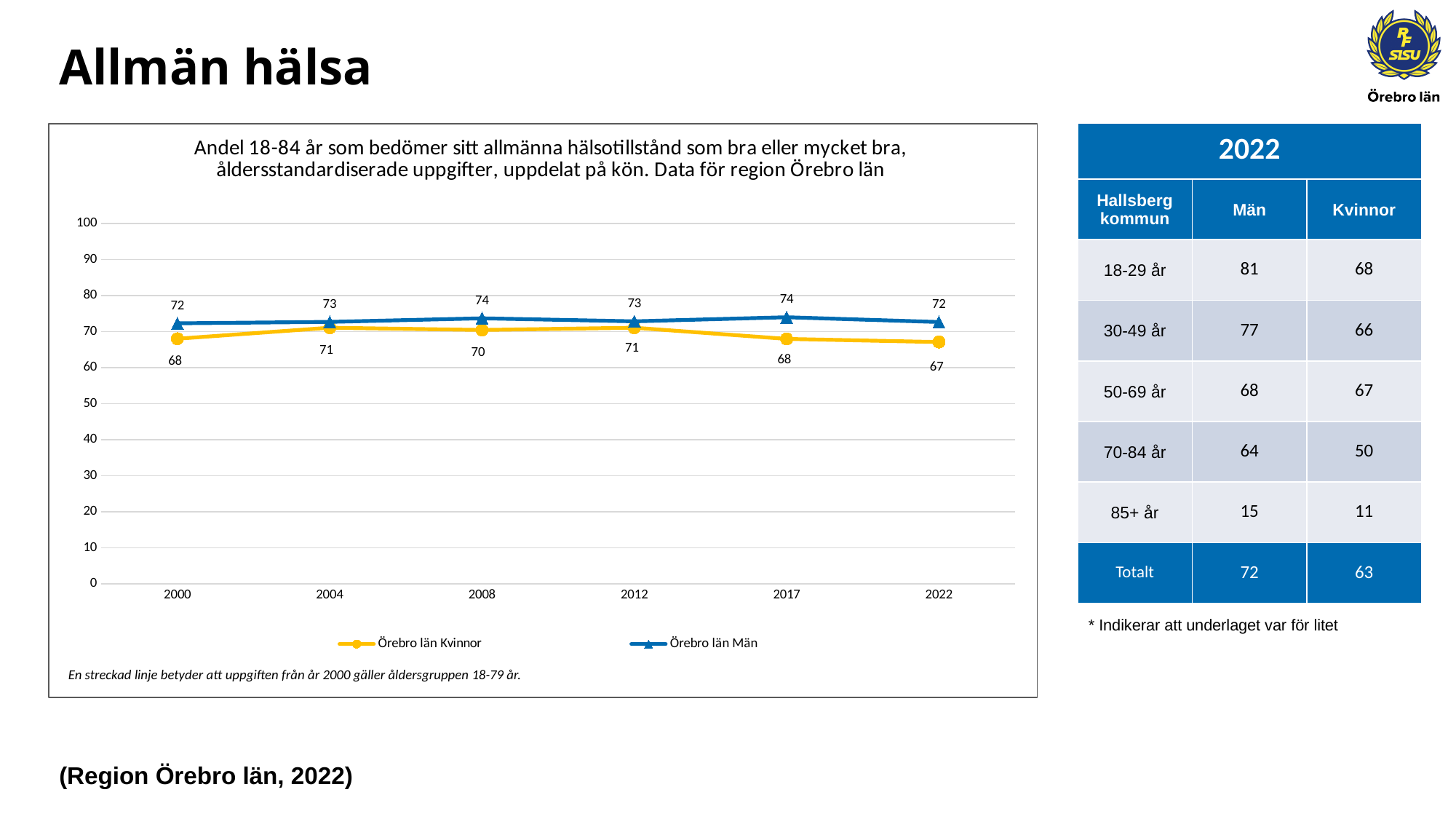
How many years are shown on the x axis? 6 What is the value for Örebro län Män in 2017? 74 Does the Örebro län Kvinnor line rise or fall from 2012 to 2022? fall What is the value for Örebro län Kvinnor in 2022? 67 Is the value for Örebro län Män in 2008 greater or less than 70? greater In which year is the Örebro län Kvinnor value lowest? 2022 What is the difference between Örebro län Män and Örebro län Kvinnor in 2017? 6 What kind of chart is shown? line chart Which series has the higher value in 2022, Örebro län Män or Örebro län Kvinnor? Örebro län Män What is the value for Örebro län Kvinnor in 2000? 68 How many series does the legend list? 2 What colour is the Örebro län Män line? blue